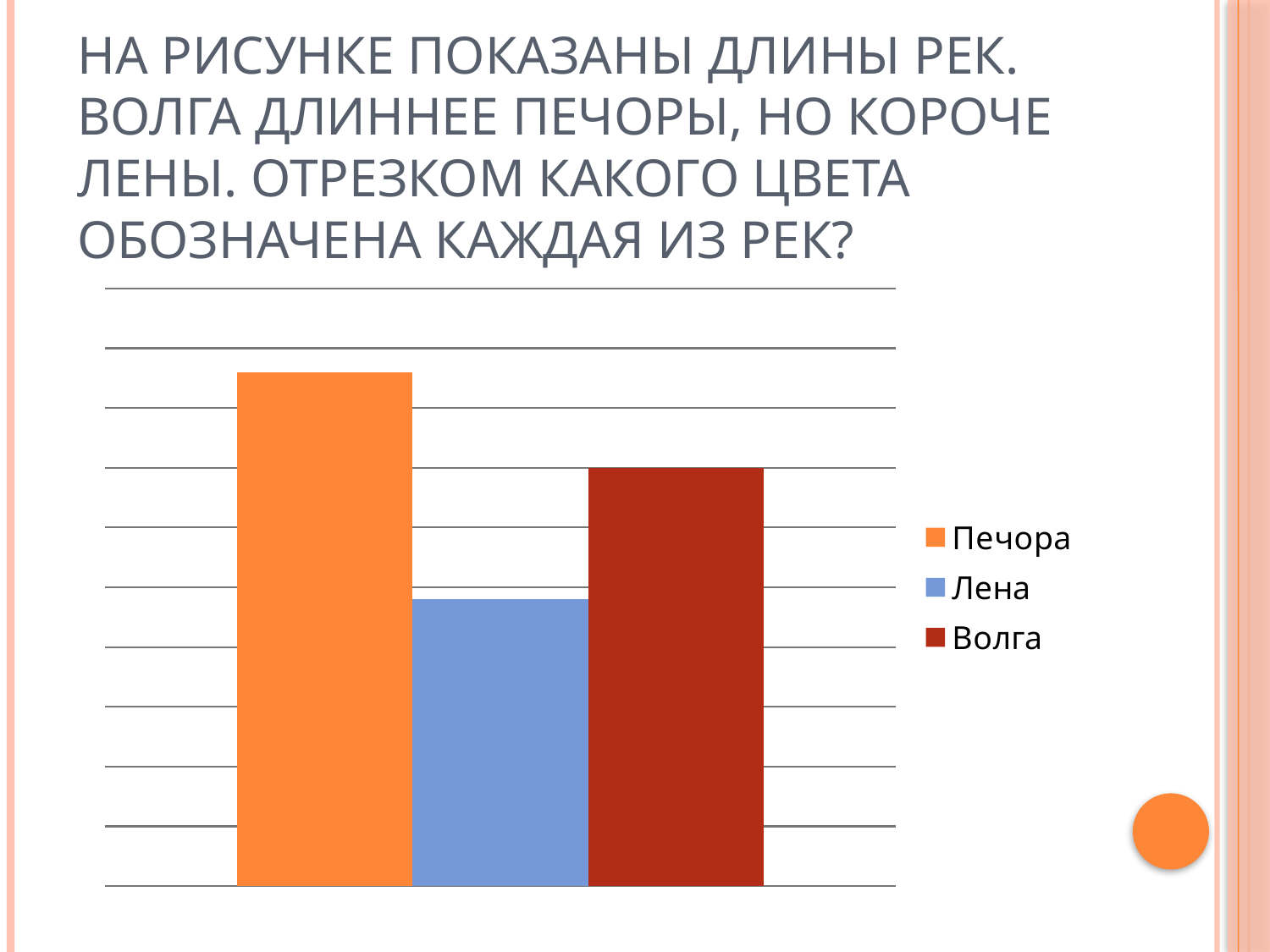
Which colour bar is the tallest in the chart? orange Which bar is taller, the dark red one or the blue one? dark red How many entries does the chart legend list? 3 Which colour bar is the shortest in the chart? blue What colour does the legend assign to Волга? dark red According to the legend, which river does the tallest bar represent? Печора What kind of chart is shown on the slide? bar chart Which bar is taller, the orange one or the dark red one? orange How many bars are plotted in the chart? 3 What are the three entries listed in the chart legend? Печора, Лена, Волга According to the legend, which river does the shortest bar represent? Лена